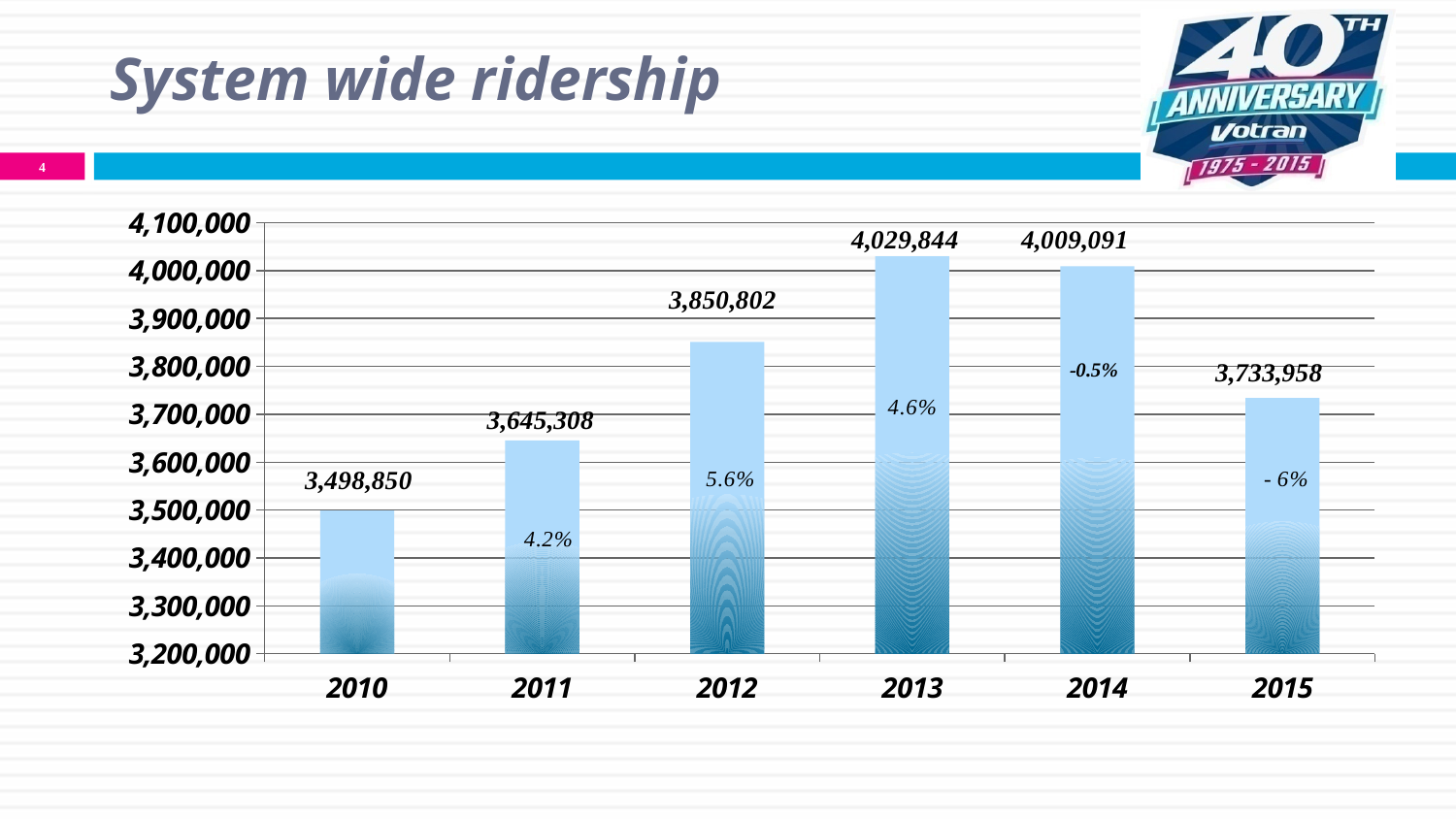
Which year has the lowest ridership? 2010 Which year has the highest ridership? 2013 What is the ridership value for 2015? 3,733,958 Which year has higher ridership, 2012 or 2015? 2012 Is the ridership value for 2011 greater or less than 3,600,000? greater What is the difference in ridership between 2013 and 2014? 20,753 What percentage change is labelled on the 2014 bar? -0.5% What is the ridership value for 2013? 4,029,844 What is the ridership value for 2010? 3,498,850 How many years are shown on the x axis? 6 What is the difference in ridership between 2013 and 2010? 530,994 What kind of chart is shown on the slide? Bar chart